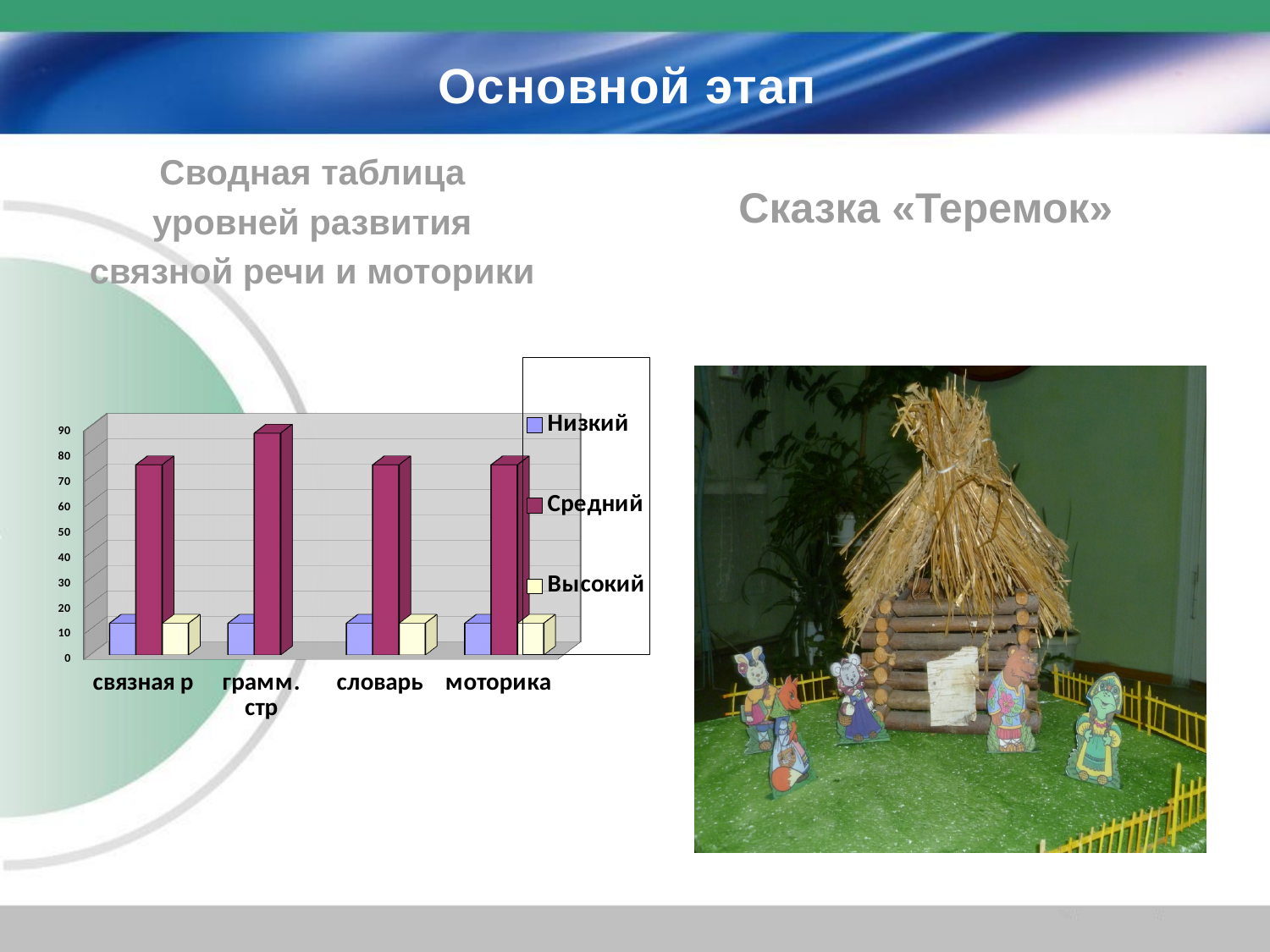
What kind of chart is shown on the slide? bar chart Is the Средний value for моторика greater or less than 70? greater How many categories are shown on the x axis of the chart? 4 How many series does the chart's legend list? 3 What are the three series named in the chart's legend? Низкий, Средний, Высокий Which category has the highest value for the Средний series? грамм. стр For the category словарь, which is larger: the Средний value or the Низкий value? Средний Is the Средний value for связная р greater or less than 80? less Is the Средний value for грамм. стр greater or less than 80? greater Which category has the lowest value for the Высокий series? грамм. стр Which series is shown with the tallest bars in every category? Средний